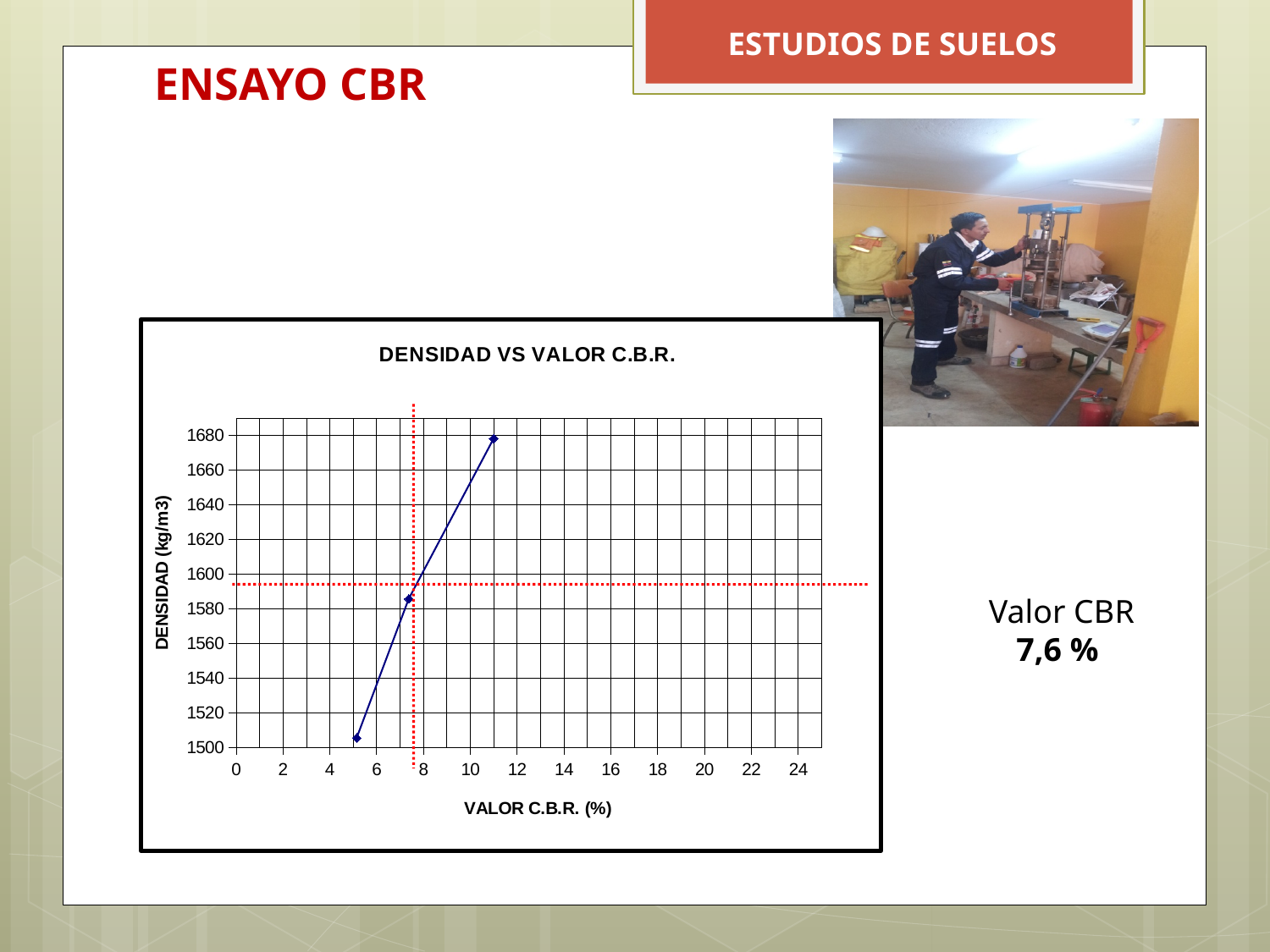
How many data points are plotted on the chart? 3 Is the density of the lowest plotted point greater or less than 1520? less What kind of chart is shown on the slide? line chart Which has the higher density: the point near C.B.R. 5 or the point near C.B.R. 11? the point near C.B.R. 11 What is the label of the y axis of the chart? DENSIDAD (kg/m3) Is the C.B.R. value of the highest-density point greater or less than 10? greater Is the density of the highest plotted point greater or less than 1660? greater Does the density rise or fall as the C.B.R. value increases along the x axis? rises What is the title of the chart? DENSIDAD VS VALOR C.B.R. What is the highest value shown on the y axis of the chart? 1680